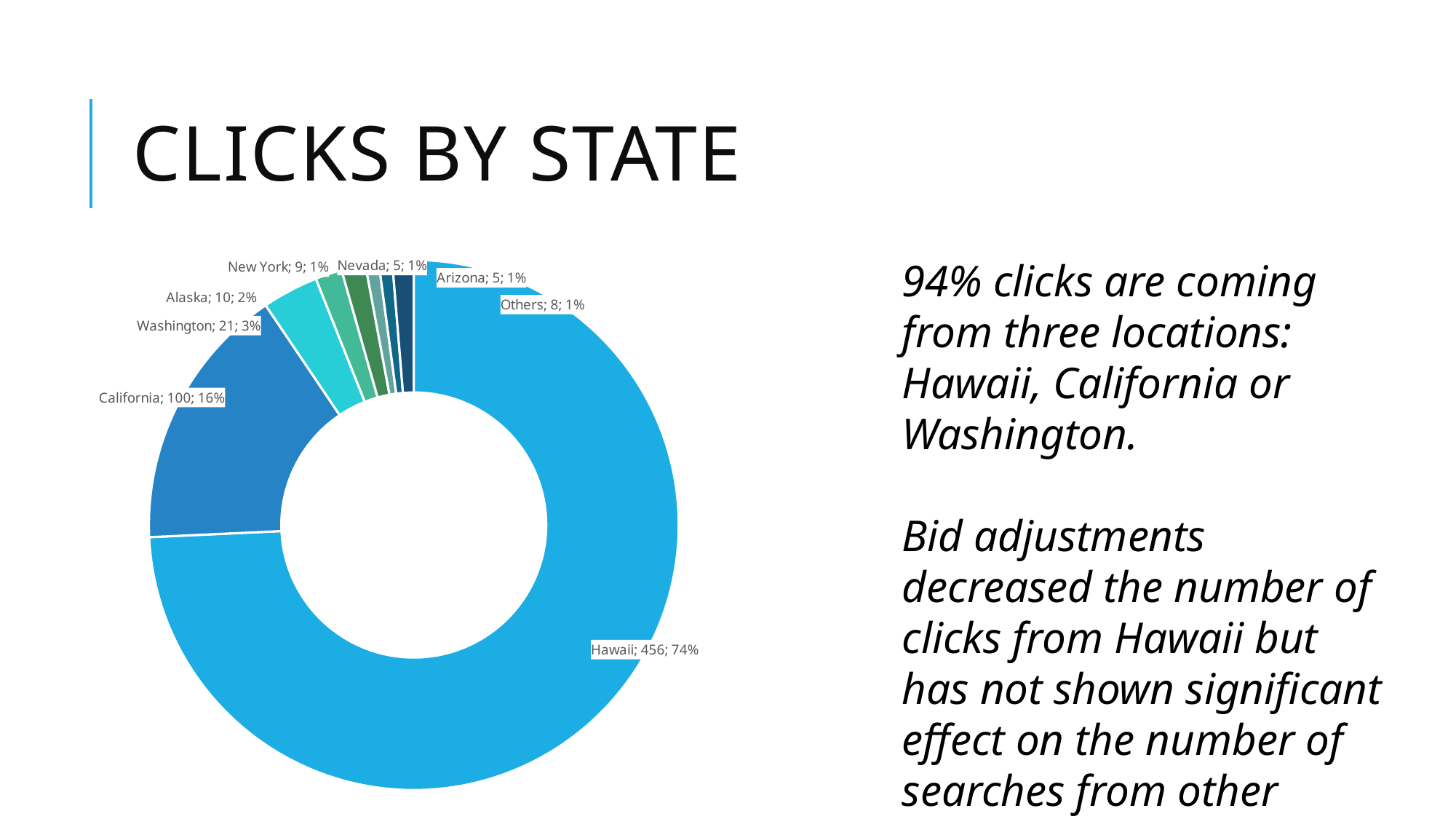
What share of clicks came from California? 16% Which state has the largest number of clicks? Hawaii How many clicks came from Alaska? 10 What kind of chart is shown on the slide? Pie chart (doughnut) How many clicks came from Washington? 21 What is the title of the chart on the slide? Clicks by State What is the difference in clicks between Hawaii and California? 356 How many clicks came from Hawaii? 456 Which has more clicks, Washington or Alaska? Washington What share of clicks came from Hawaii? 74% What share of clicks came from Washington? 3% How many clicks are in the Others category? 8